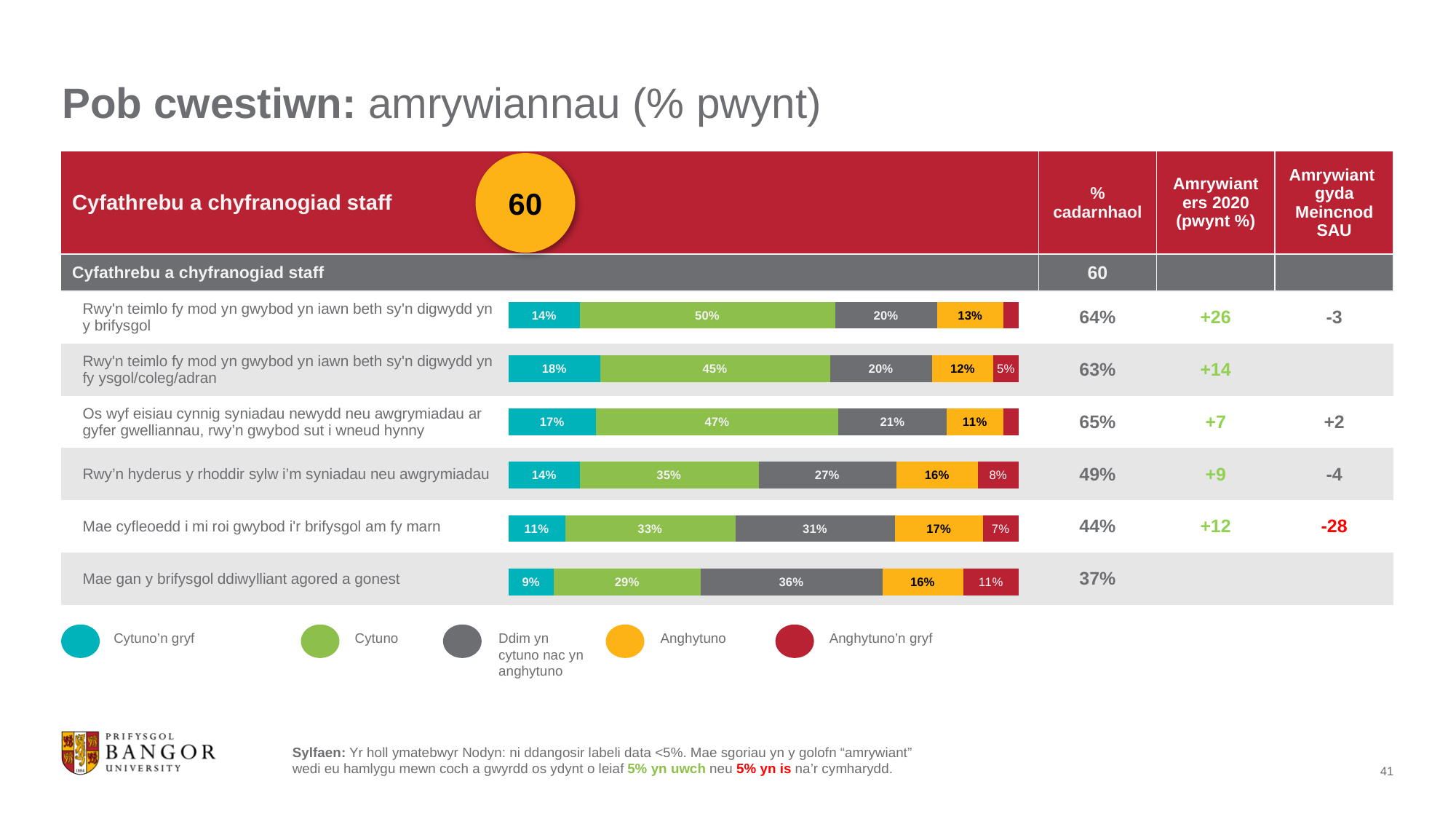
Which statement has the lowest Cytuno'n gryf value? Mae gan y brifysgol ddiwylliant agored a gonest What is the total of the stacked bar for "Rwy'n hyderus y rhoddir sylw i'm syniadau neu awgrymiadau"? 100% What is the Cytuno'n gryf value for "Rwy'n teimlo fy mod yn gwybod yn iawn beth sy'n digwydd yn fy ysgol/coleg/adran"? 18% What is the difference between the Cytuno values for "Rwy'n teimlo fy mod yn gwybod yn iawn beth sy'n digwydd yn y brifysgol" and "Mae gan y brifysgol ddiwylliant agored a gonest"? 21 percentage points Which is larger: the Anghytuno value for "Rwy'n hyderus y rhoddir sylw i'm syniadau neu awgrymiadau" or for "Os wyf eisiau cynnig syniadau newydd neu awgrymiadau ar gyfer gwelliannau, rwy'n gwybod sut i wneud hynny"? Rwy'n hyderus y rhoddir sylw i'm syniadau neu awgrymiadau Which statement has the highest Cytuno value? Rwy'n teimlo fy mod yn gwybod yn iawn beth sy'n digwydd yn y brifysgol What kind of chart is shown on the slide? bar chart What is the Cytuno value for "Mae gan y brifysgol ddiwylliant agored a gonest"? 29% How many statements (bars) are plotted in the chart? 6 How many series does the legend list? 5 Which colour represents Anghytuno'n gryf in the legend? red What is the Ddim yn cytuno nac yn anghytuno value for "Mae cyfleoedd i mi roi gwybod i'r brifysgol am fy marn"? 31%